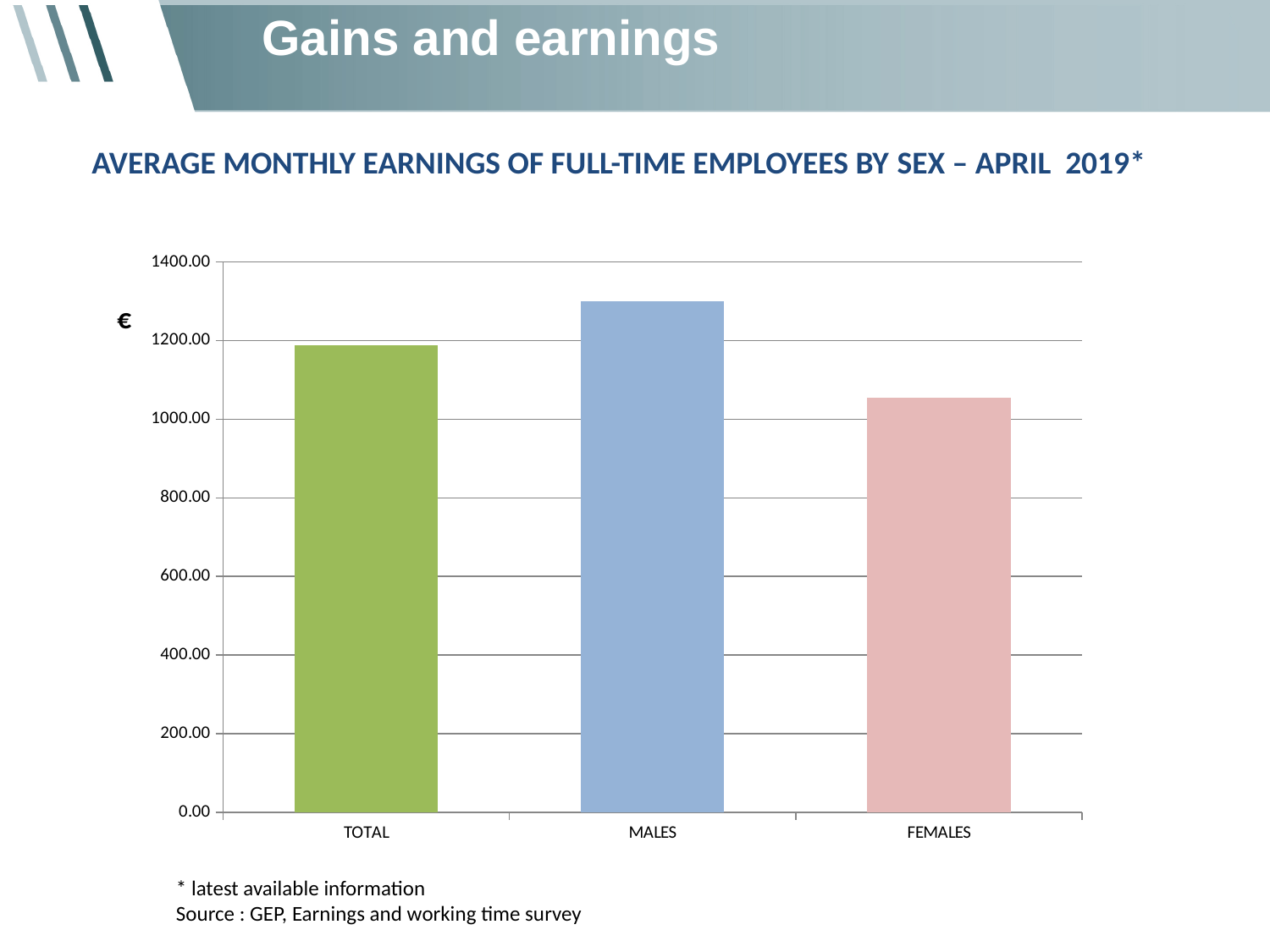
Which is larger, the value for MALES or the value for FEMALES? MALES What type of chart is shown on the slide? bar chart Which category has the highest average monthly earnings? MALES What colour is the bar for MALES? blue How many categories are shown on the x axis of the chart? 3 Is the value for FEMALES greater or less than 1200.00? less Is the value for MALES greater or less than 1200.00? greater Which category has the lowest average monthly earnings? FEMALES Is the value for TOTAL greater or less than 1000.00? greater Which is larger, the value for TOTAL or the value for MALES? MALES What is the title of the chart? AVERAGE MONTHLY EARNINGS OF FULL-TIME EMPLOYEES BY SEX – APRIL 2019*